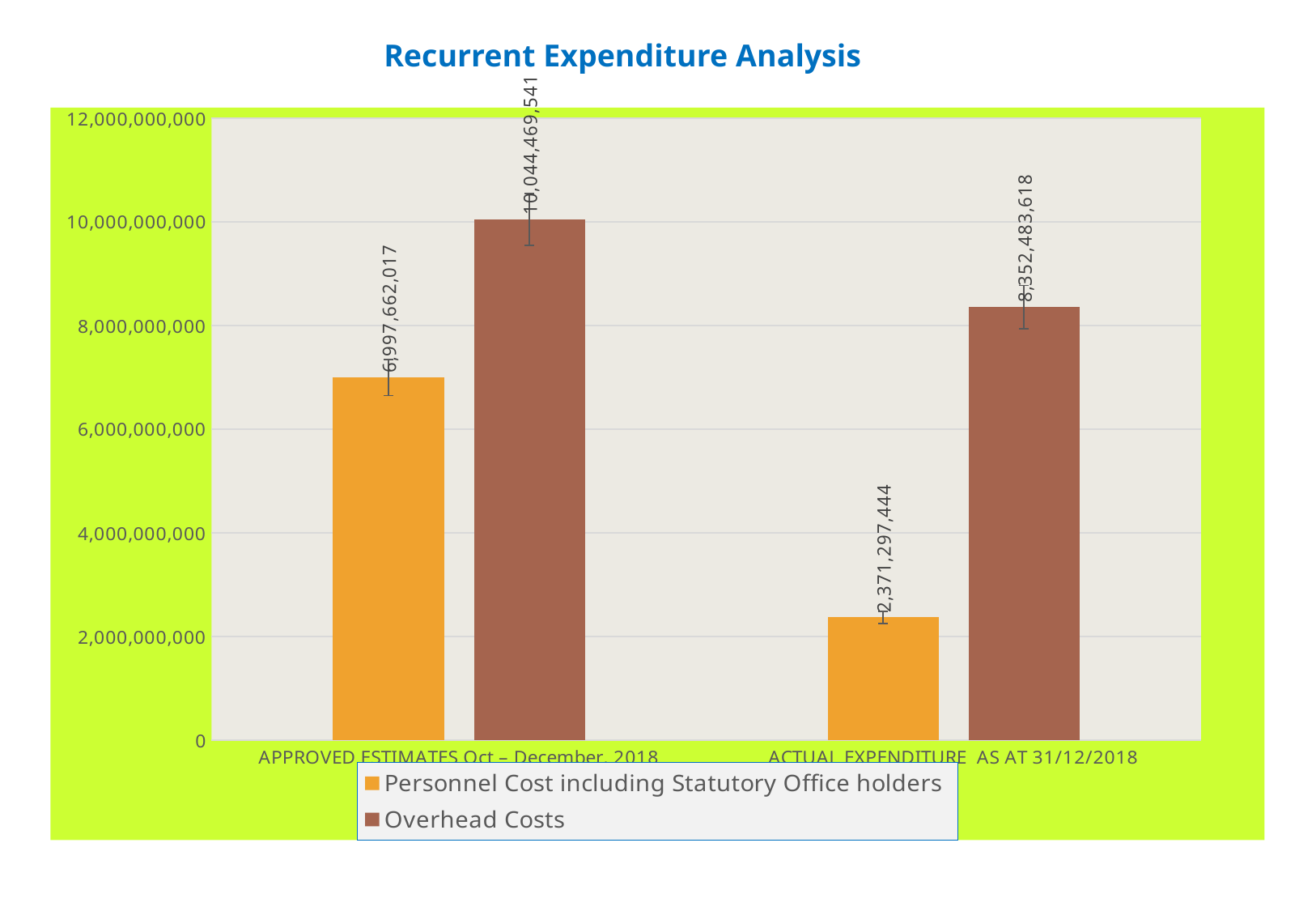
What is the difference between Overhead Costs and Personnel Cost including Statutory Office holders for APPROVED ESTIMATES Oct – December, 2018? 3,046,807,524 What is the difference between the Personnel Cost including Statutory Office holders values for APPROVED ESTIMATES Oct – December, 2018 and ACTUAL EXPENDITURE AS AT 31/12/2018? 4,626,364,573 What is the Overhead Costs value for ACTUAL EXPENDITURE AS AT 31/12/2018? 8,352,483,618 Which bar has the highest value in the chart? Overhead Costs for APPROVED ESTIMATES Oct – December, 2018 How many categories are shown on the x axis? 2 How many series does the legend list? 2 What is the title of the chart? Recurrent Expenditure Analysis What is the Overhead Costs value for APPROVED ESTIMATES Oct – December, 2018? 10,044,469,541 What is the Personnel Cost including Statutory Office holders value for ACTUAL EXPENDITURE AS AT 31/12/2018? 2,371,297,444 What kind of chart is shown on the slide? Bar chart Which bar has the lowest value in the chart? Personnel Cost including Statutory Office holders for ACTUAL EXPENDITURE AS AT 31/12/2018 Which is larger: Overhead Costs for ACTUAL EXPENDITURE AS AT 31/12/2018 or Personnel Cost including Statutory Office holders for APPROVED ESTIMATES Oct – December, 2018? Overhead Costs for ACTUAL EXPENDITURE AS AT 31/12/2018